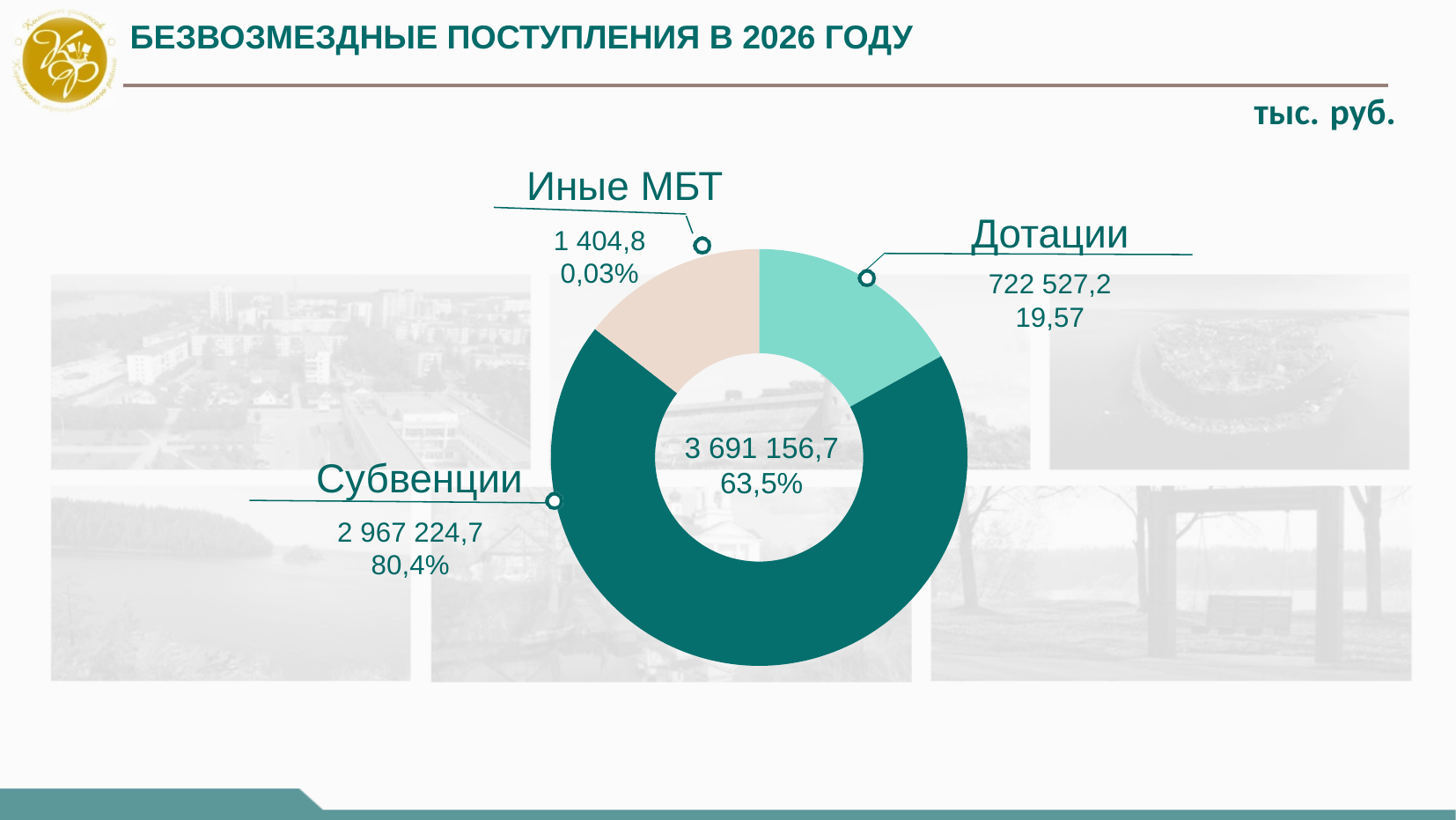
What is the value for Дотации? 722 527,2 What kind of chart is shown on the slide? Donut (pie) chart What is the value for Иные МБТ? 1 404,8 Which category has the smallest value? Иные МБТ Which category has the largest value? Субвенции Which is larger, Дотации or Иные МБТ? Дотации What total value is shown in the centre of the donut chart? 3 691 156,7 What share of the chart does Субвенции account for? 80,4% In what units are the chart values given, according to the slide? тыс. руб. What share is shown for Иные МБТ? 0,03% What is the difference between the values for Субвенции and Дотации? 2 244 697,5 What is the value for Субвенции? 2 967 224,7